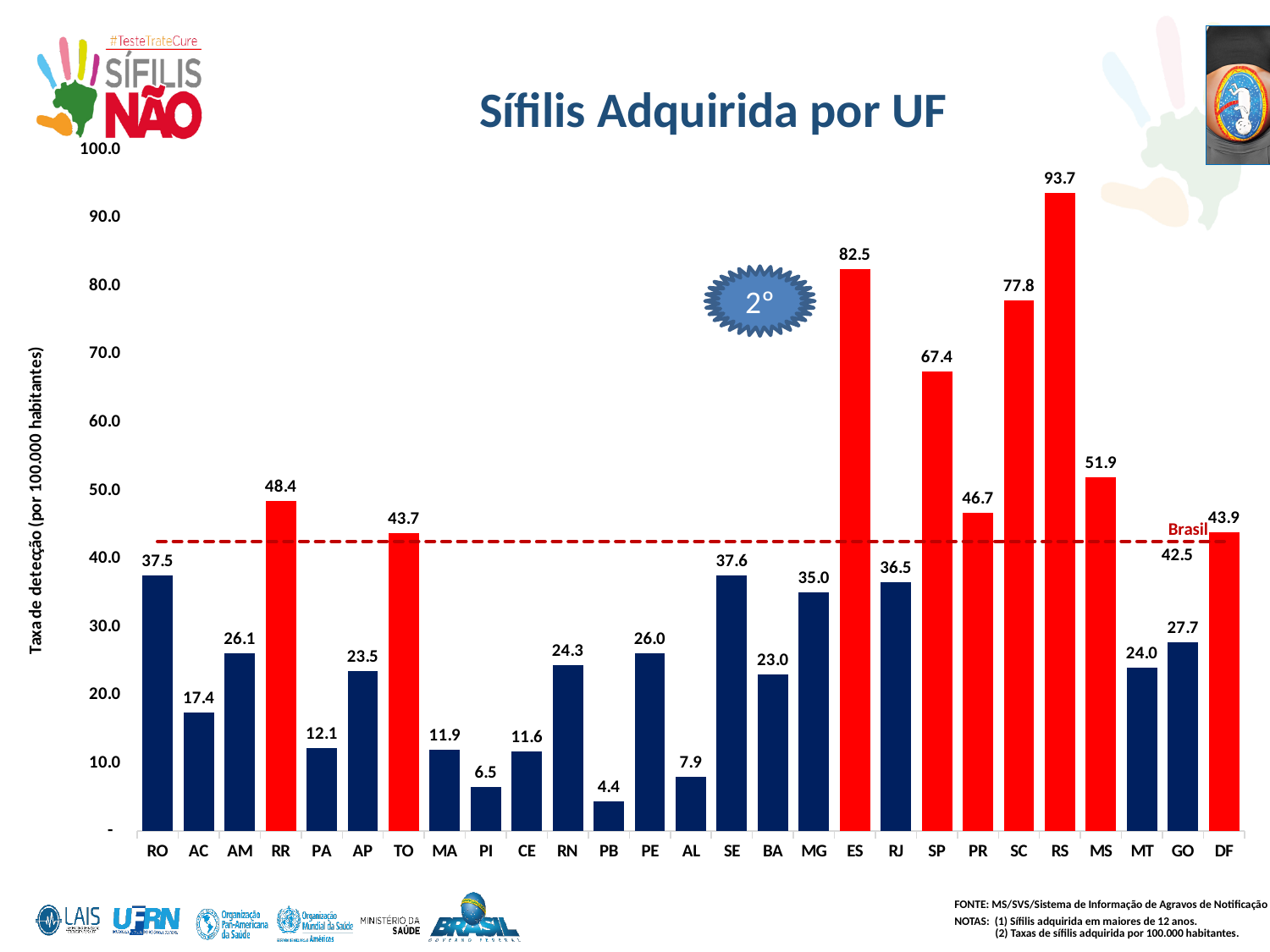
What is the difference between the values for ES and SP? 15.1 Which UF has the lowest value? PB What value is shown for the dashed 'Brasil' reference line? 42.5 What is the value for PB? 4.4 What is the value for ES? 82.5 Which UF has the highest value? RS How many UFs are shown on the x axis? 27 Which is larger, the value for SC or the value for ES? ES What is the value for TO? 43.7 Is the value for MG greater or less than 30.0? greater What is the value for RS? 93.7 What kind of chart is this? bar chart